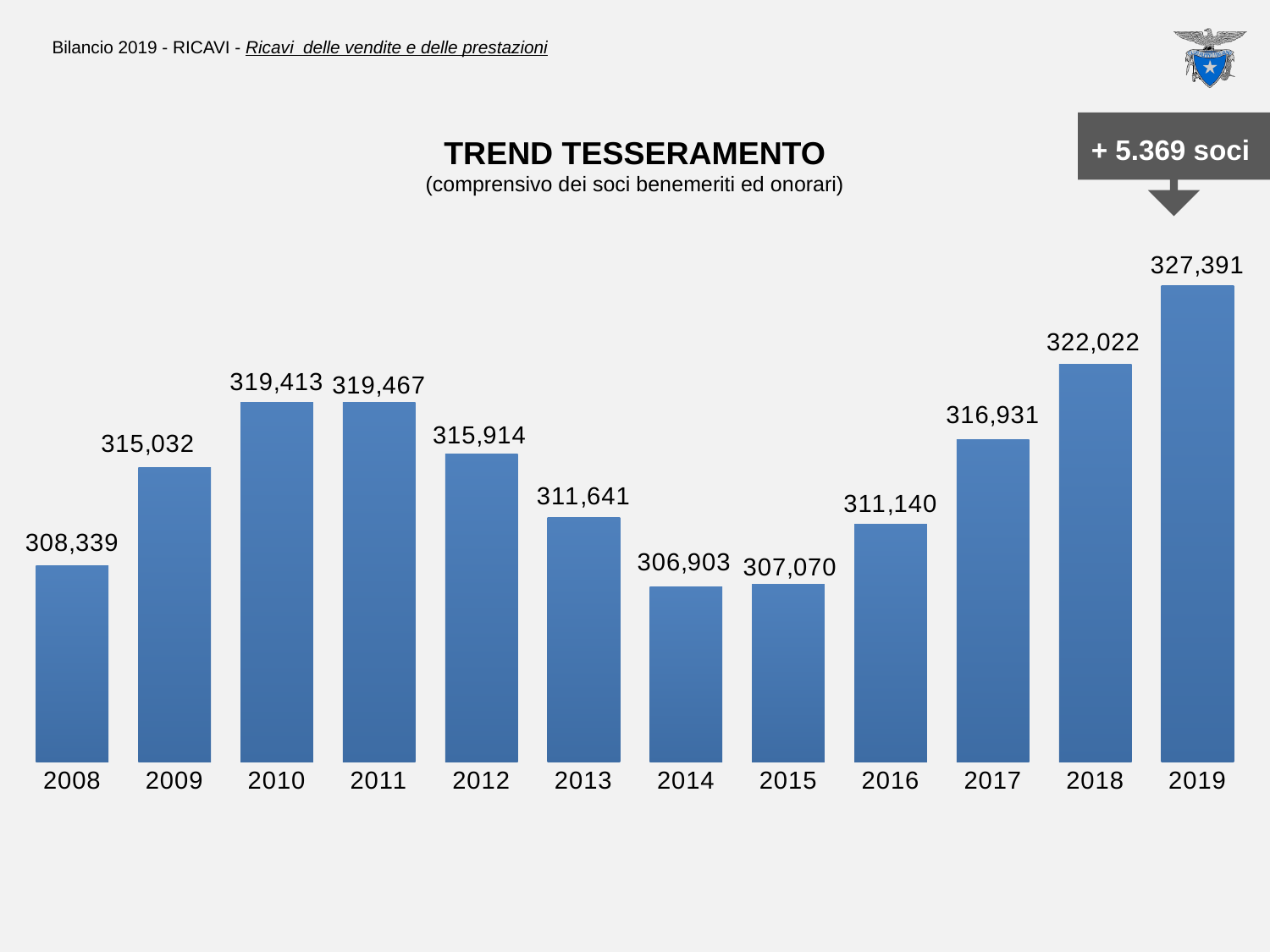
How many years are shown in the TREND TESSERAMENTO chart? 12 Which is larger in the TREND TESSERAMENTO chart, the value for 2009 or the value for 2012? 2012 What is the subtitle shown under the title TREND TESSERAMENTO? (comprensivo dei soci benemeriti ed onorari) Do the values in the TREND TESSERAMENTO chart rise or fall from 2014 to 2019? Rise What is the difference between the values for 2019 and 2018 in the TREND TESSERAMENTO chart? 5,369 Which year has the highest value in the TREND TESSERAMENTO chart? 2019 What is the value for 2008 in the TREND TESSERAMENTO chart? 308,339 What is the value for 2014 in the TREND TESSERAMENTO chart? 306,903 Which year has the lowest value in the TREND TESSERAMENTO chart? 2014 What is the value for 2019 in the TREND TESSERAMENTO chart? 327,391 What is the difference between the values for 2011 and 2010 in the TREND TESSERAMENTO chart? 54 What kind of chart is the TREND TESSERAMENTO chart? Bar chart